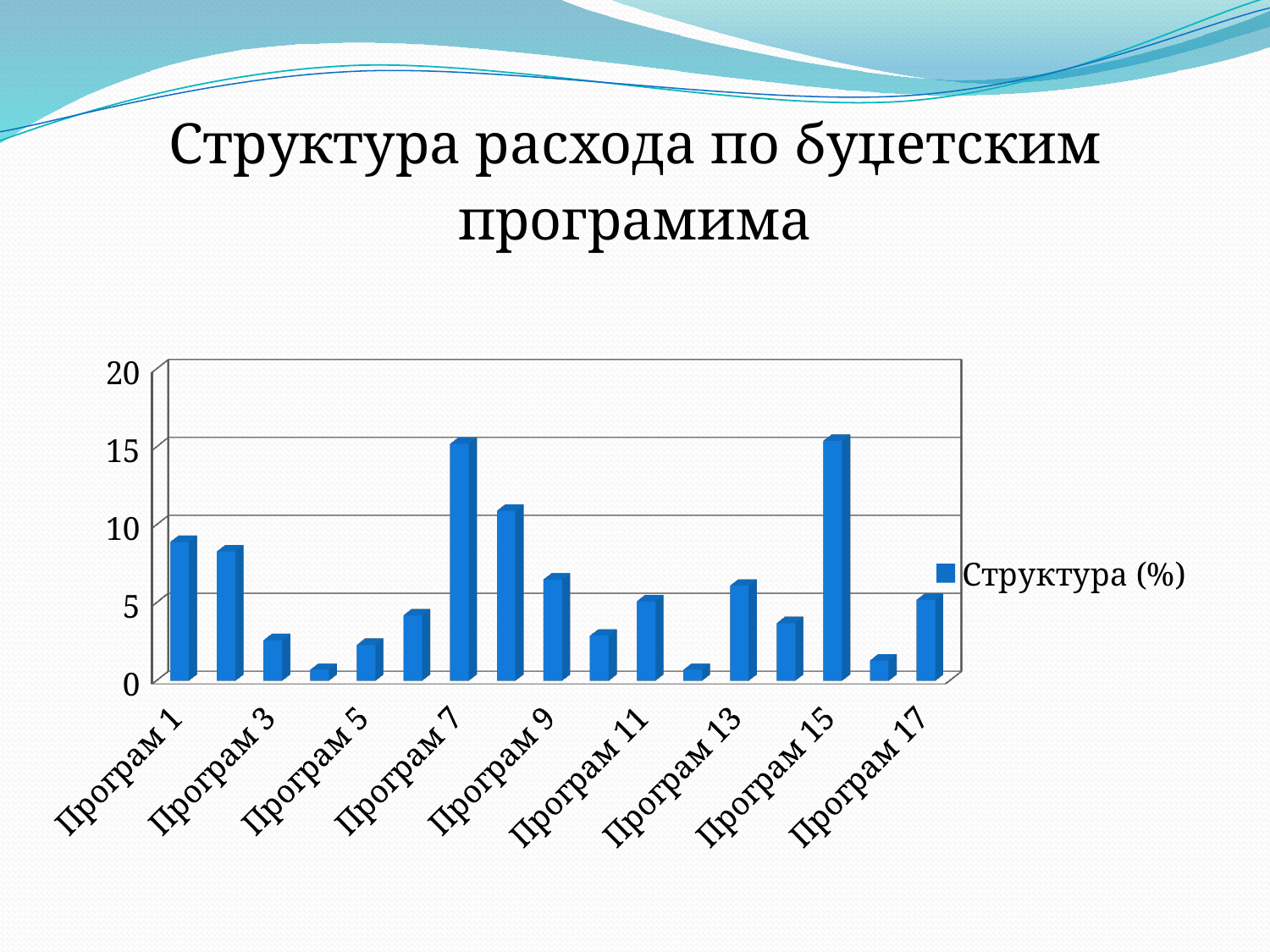
Is the value for Програм 15 greater or less than 10? greater How many series does the legend list? 1 What is the legend entry for the series in the chart? Структура (%) How many bars are plotted in the chart? 17 Is the value for Програм 3 greater or less than 5? less What kind of chart is shown on the slide? bar chart Which has the larger value, Програм 1 or Програм 3? Програм 1 Which has the larger value, Програм 7 or Програм 9? Програм 7 Is the value for Програм 7 greater or less than 10? greater Which has the larger value, Програм 13 or Програм 17? Програм 13 What is the title of the slide? Структура расхода по буџетским програмима